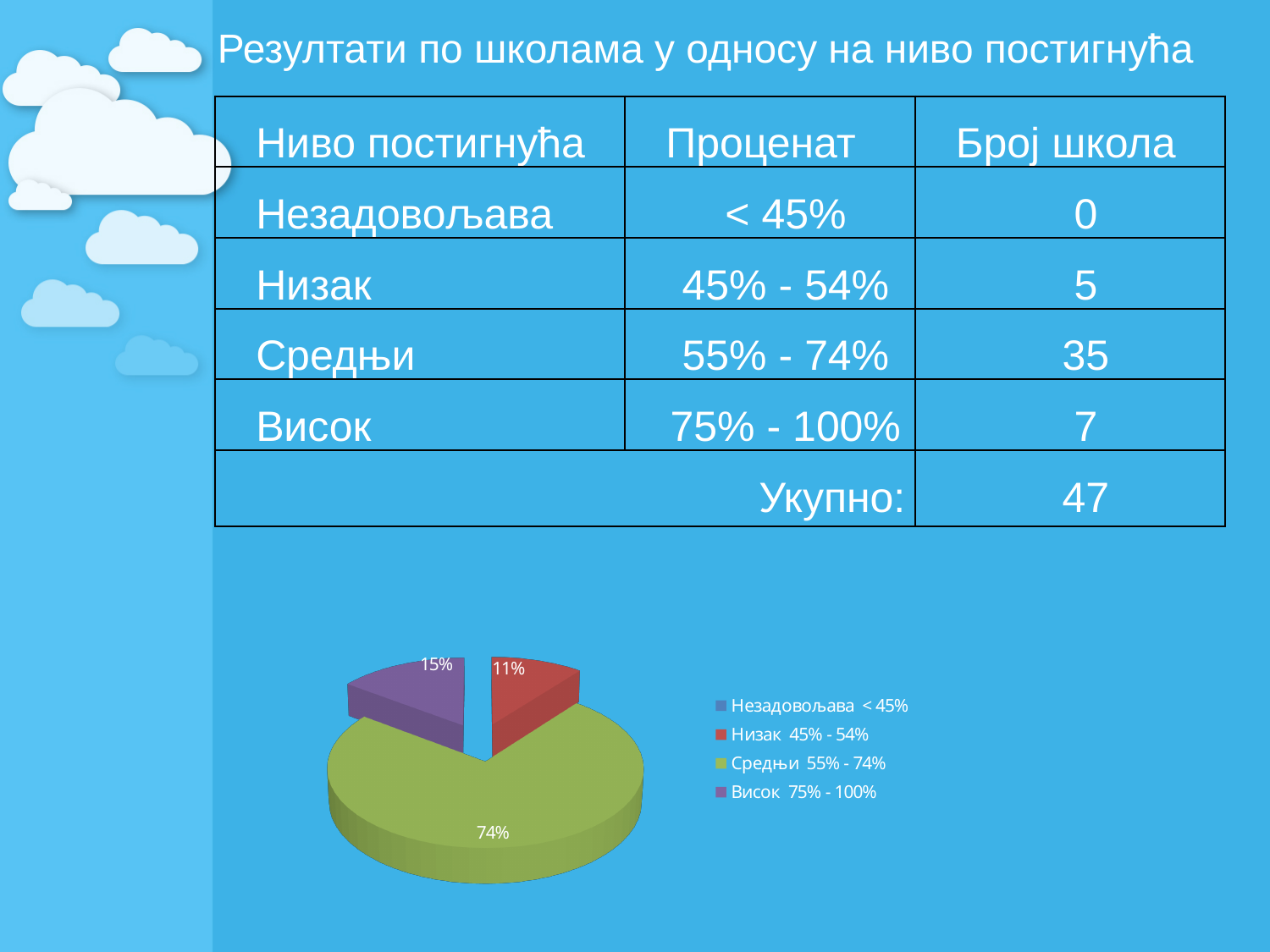
What is the difference in percentage points between the Средњи 55% - 74% slice and the Висок 75% - 100% slice? 59% What kind of chart is shown on the slide? pie chart What share of the pie does the Висок 75% - 100% slice represent? 15% What is the difference in percentage points between the Висок 75% - 100% slice and the Низак 45% - 54% slice? 4% What share of the pie does the Низак 45% - 54% slice represent? 11% What colour is the Низак 45% - 54% slice in the pie chart? red What share of the pie does the Средњи 55% - 74% slice represent? 74% What colour is the Средњи 55% - 74% slice in the pie chart? green Which slice is larger, Висок 75% - 100% or Низак 45% - 54%? Висок 75% - 100% Which category has the largest slice of the pie? Средњи 55% - 74% Which of the labelled slices is the smallest? Низак 45% - 54% How many entries does the pie chart legend list? 4